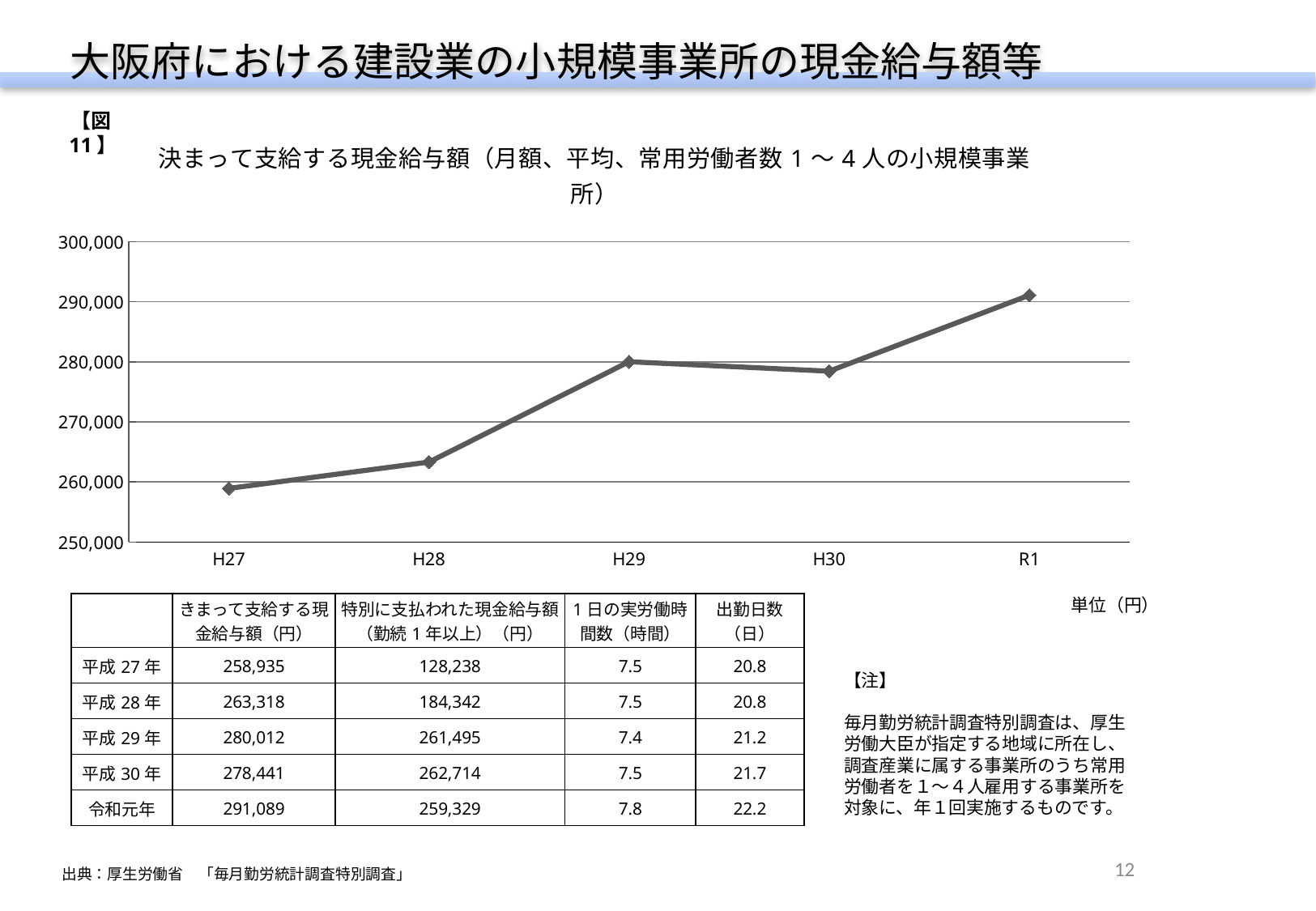
According to the table on the slide, what is the きまって支給する現金給与額 for 平成29年? 280,012 Which is larger, the value for H29 or the value for H30? H29 What is the lowest value shown on the vertical axis of the chart? 250,000 Which year has the lowest value on the line chart? H27 Using the table values, what is the difference between the きまって支給する現金給与額 for 令和元年 and 平成27年? 32,154 Is the value for H30 greater or less than 280,000? less What kind of chart is shown on the slide? line chart Is the value for R1 greater or less than 290,000? greater According to the table on the slide, what is the きまって支給する現金給与額 for 令和元年? 291,089 Is the value for H27 greater or less than 260,000? less Which year has the highest value on the line chart? R1 How many data points are plotted on the line chart? 5